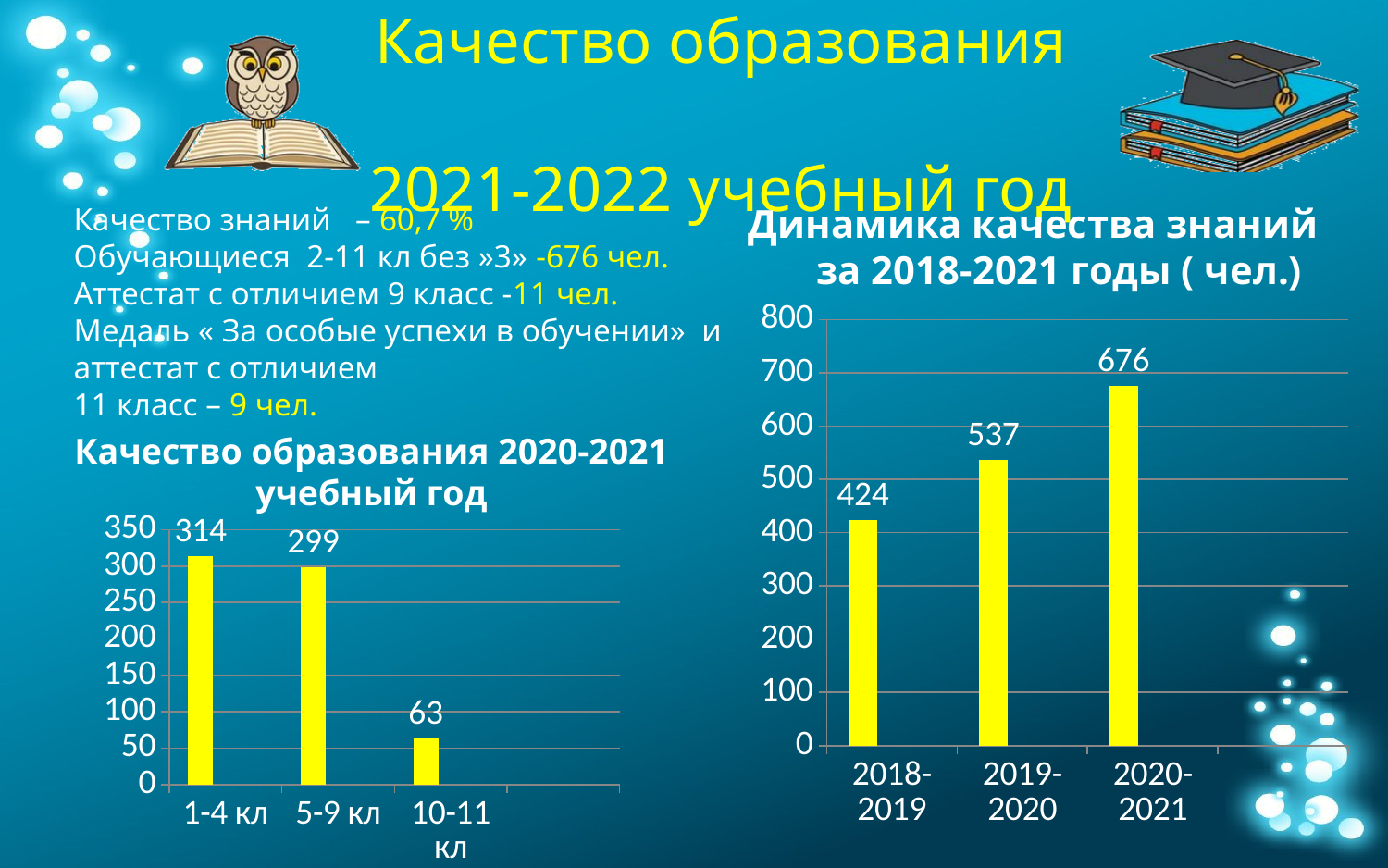
In the chart 'Динамика качества знаний за 2018-2021 годы', is the value for 2019-2020 greater or less than 500? greater In the chart 'Качество образования 2020-2021 учебный год', what is the value for 1-4 кл? 314 In the chart 'Динамика качества знаний за 2018-2021 годы', which year has the highest value? 2020-2021 In the chart 'Качество образования 2020-2021 учебный год', what is the value for 10-11 кл? 63 In the chart 'Динамика качества знаний за 2018-2021 годы', what is the value for 2018-2019? 424 In the chart 'Динамика качества знаний за 2018-2021 годы', what is the value for 2019-2020? 537 In the chart 'Динамика качества знаний за 2018-2021 годы', do the values rise or fall from 2018-2019 to 2020-2021? rise In the chart 'Динамика качества знаний за 2018-2021 годы', what is the difference between the values for 2020-2021 and 2018-2019? 252 In the chart 'Качество образования 2020-2021 учебный год', how many categories are shown? 3 In the chart 'Качество образования 2020-2021 учебный год', what is the difference between the values for 1-4 кл and 5-9 кл? 15 In the chart 'Качество образования 2020-2021 учебный год', which category has the lowest value? 10-11 кл What type of chart is the chart on the right side of the slide? bar chart